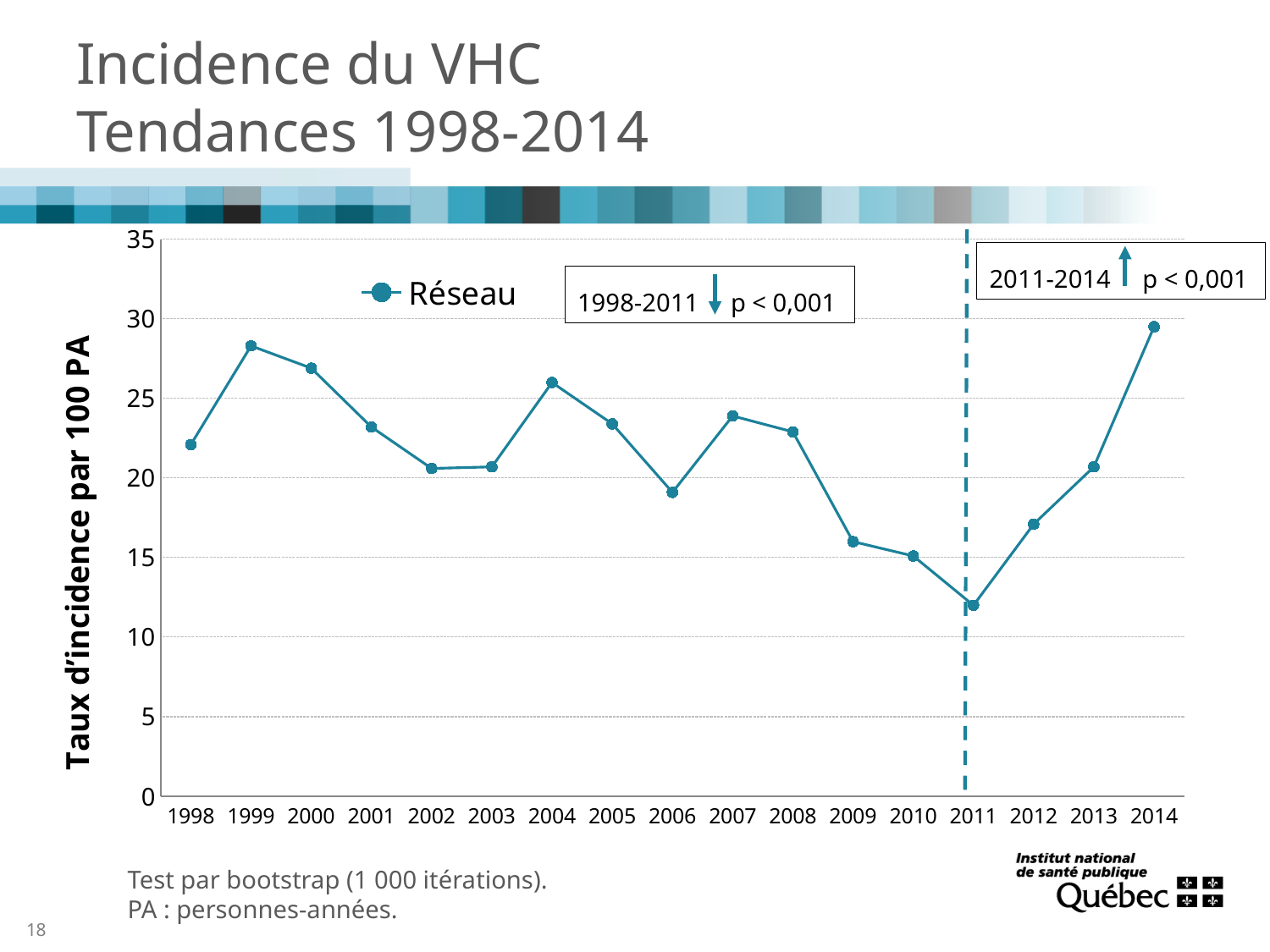
What is the name of the series shown in the legend? Réseau Is the value for 2006 greater or less than 20? less Is the value for 2014 greater or less than 25? greater How many series does the legend list? 1 Do the values rise or fall from 2011 to 2014? rise What kind of chart is shown on the slide? line chart Is the value for 2000 greater or less than 25? greater How many years (data points) are plotted along the x axis? 17 Which year has the highest incidence rate? 2014 Which year has the larger value, 2004 or 2005? 2004 Which year has the lowest incidence rate? 2011